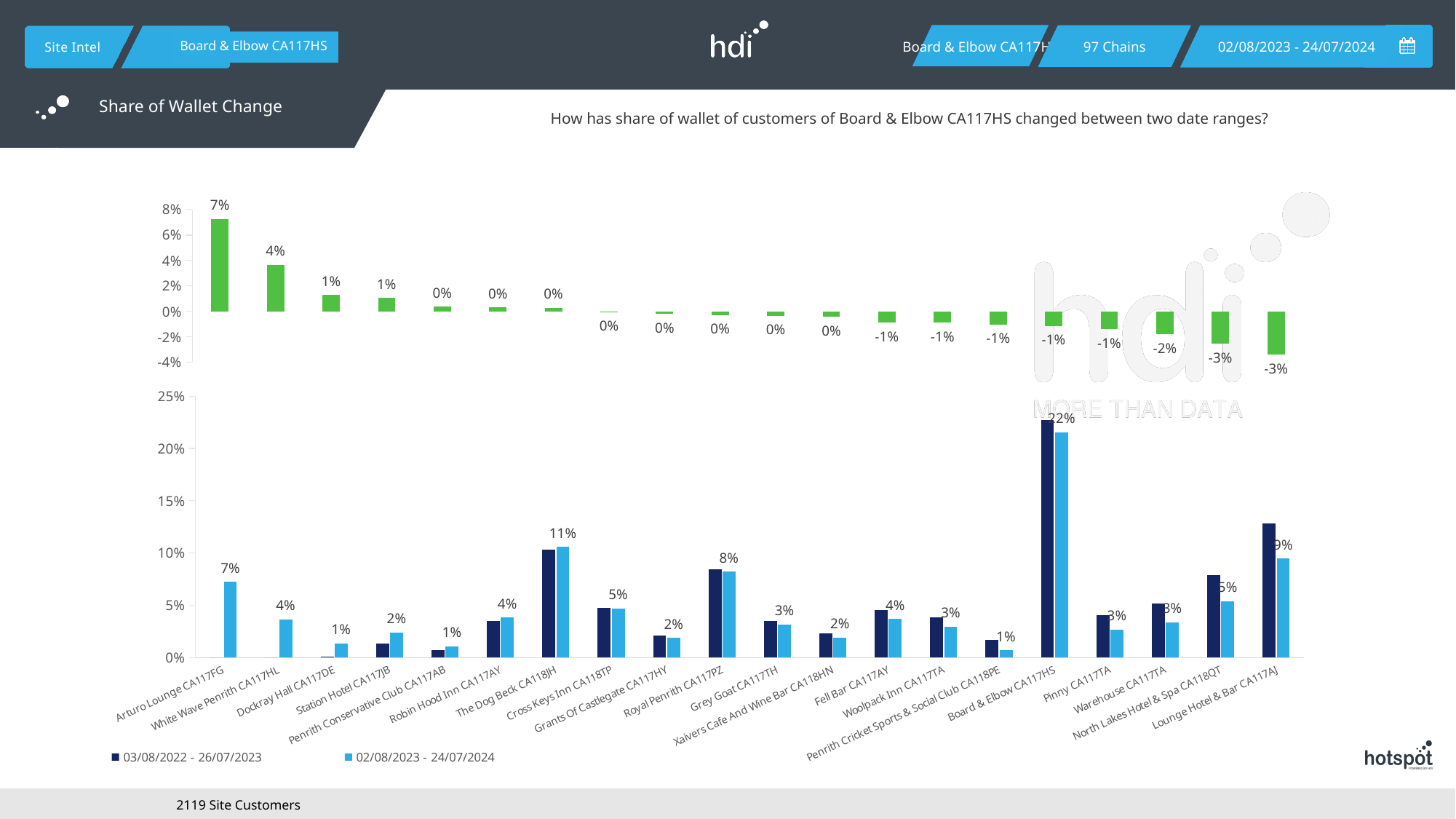
What kind of chart is the bottom chart? bar chart In the bottom chart, which is larger in the 02/08/2023 - 24/07/2024 series: Royal Penrith CA117PZ or Cross Keys Inn CA118TP? Royal Penrith CA117PZ In the bottom chart, which category has the highest value in the 02/08/2023 - 24/07/2024 series? Board & Elbow CA117HS In the bottom chart, is the 03/08/2022 - 26/07/2023 value for Lounge Hotel & Bar CA117AJ greater or less than 10%? greater In the bottom chart, what is the value for Board & Elbow CA117HS in the 02/08/2023 - 24/07/2024 series? 22% In the top chart, do the values rise or fall moving from left to right along the x axis? fall In the bottom chart, what is the value for The Dog Beck CA118JH in the 02/08/2023 - 24/07/2024 series? 11% How many series does the legend of the bottom chart list? 2 In the top chart, what is the share of wallet change for Warehouse CA117TA? -2% In the top chart, what is the share of wallet change for Arturo Lounge CA117FG? 7% In the top chart, which category has the highest share of wallet change? Arturo Lounge CA117FG In the bottom chart, what is the difference between the 02/08/2023 - 24/07/2024 values for Board & Elbow CA117HS and The Dog Beck CA118JH? 11%